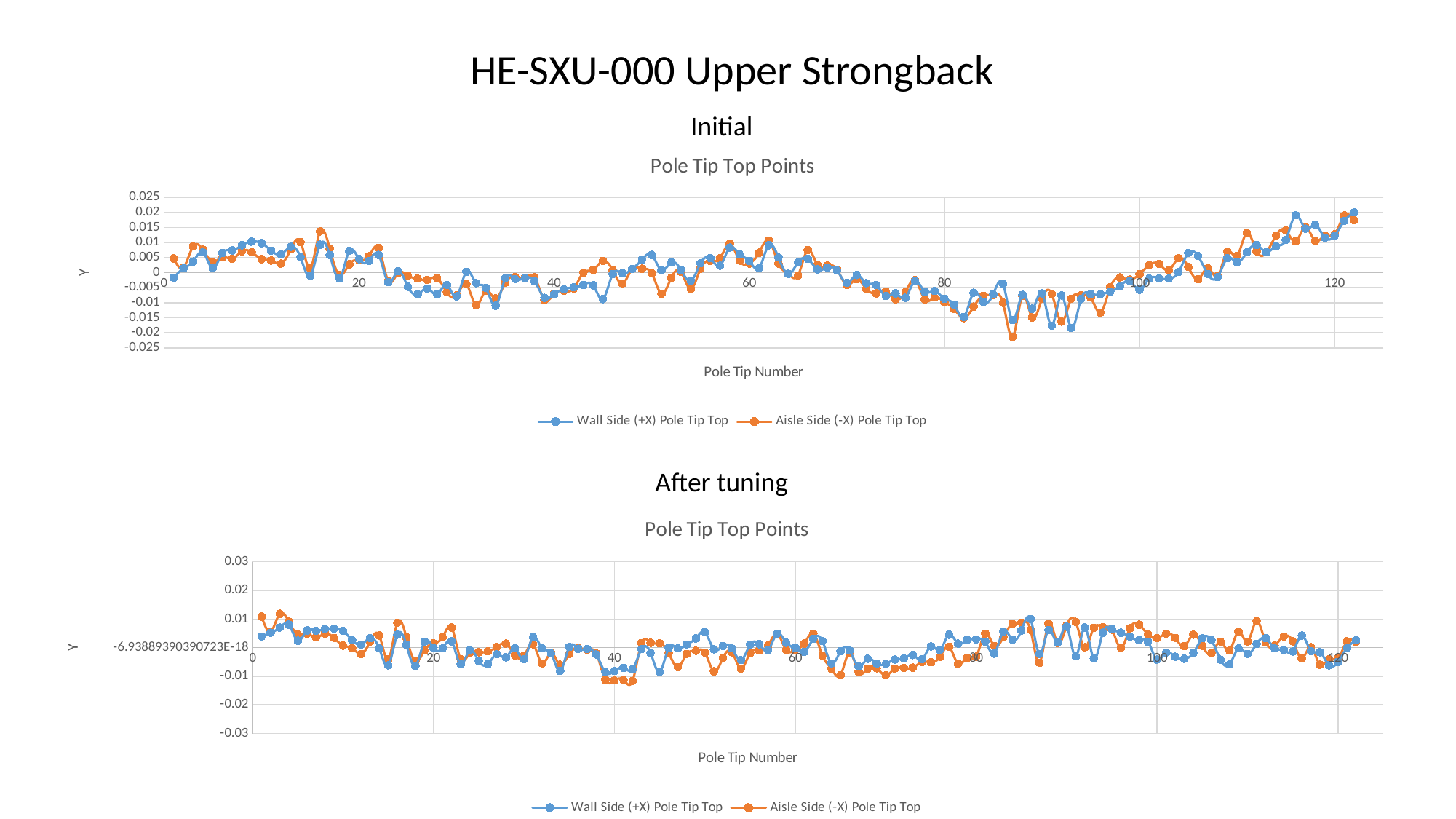
In the Initial chart, does the Aisle Side (-X) Pole Tip Top series generally rise or fall between pole tip number 0 and 30? fall What kind of chart is the Initial chart? line chart In the Initial chart, what is the title of the x axis? Pole Tip Number In the After tuning chart, which series is drawn in orange? Aisle Side (-X) Pole Tip Top What is the chart title shown above the plot area of the After tuning chart? Pole Tip Top Points In the Initial chart, does the Wall Side (+X) Pole Tip Top series generally rise or fall between pole tip number 100 and 120? rise In the Initial chart, is the Wall Side (+X) Pole Tip Top value at pole tip number 120 greater or less than 0.01? greater How many series does the legend of the After tuning chart list? 2 In the After tuning chart, is the Aisle Side (-X) Pole Tip Top value at pole tip number 3 greater or less than 0? greater